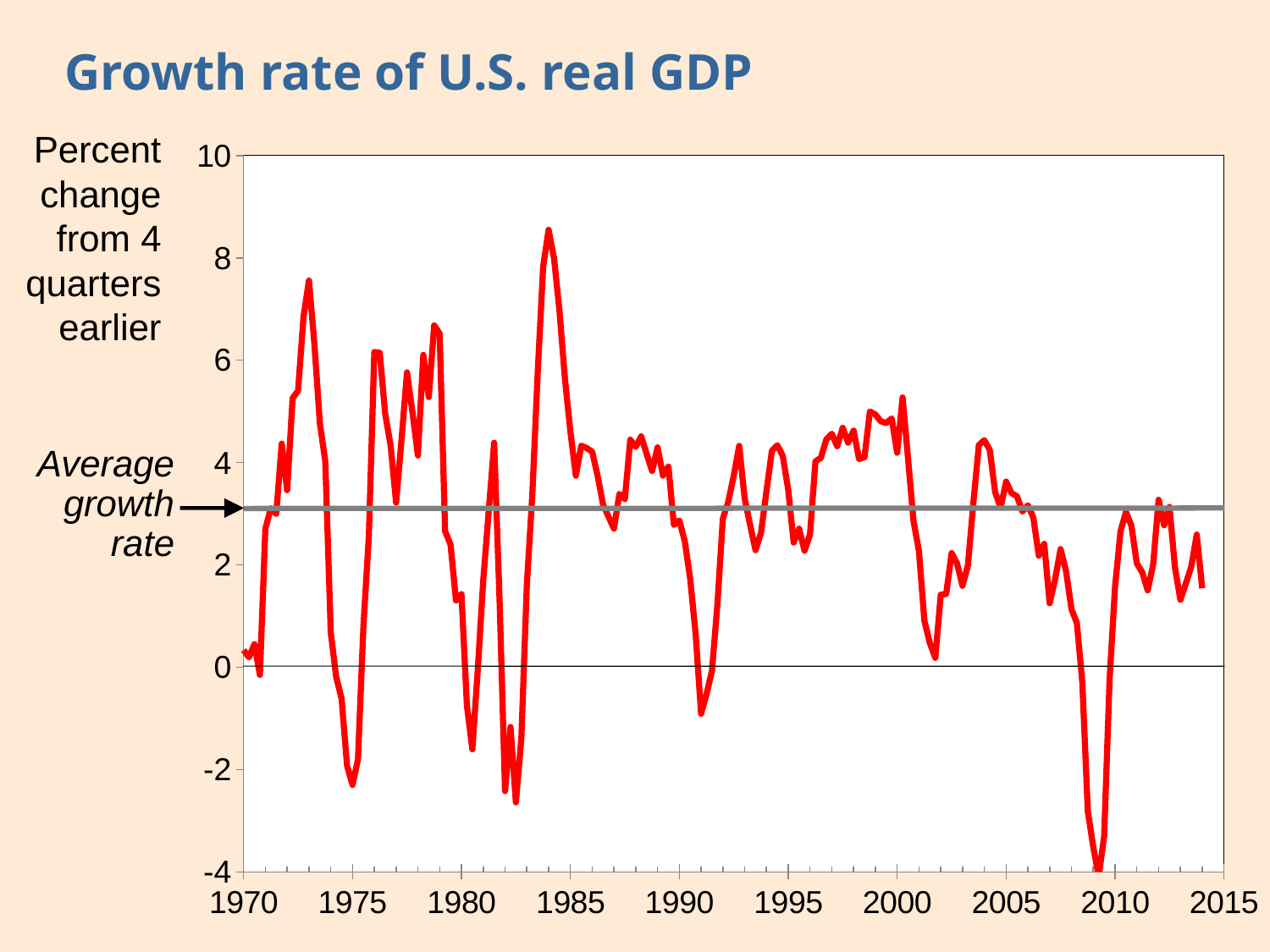
Which peak is higher: the one around 1973 or the one around 1984? 1984 Is the average growth rate line greater or less than 2? greater Around which year does the growth rate reach its lowest point on the chart? 2009 Is the peak growth rate reached around 1973 greater or less than 6? greater Is the peak growth rate reached around 1984 greater or less than 8? greater Which trough is lower: the one around 1982 or the one around 2009? 2009 What is the title of the chart? Growth rate of U.S. real GDP What kind of chart is shown on the slide? line chart What does the horizontal gray line on the chart represent? Average growth rate